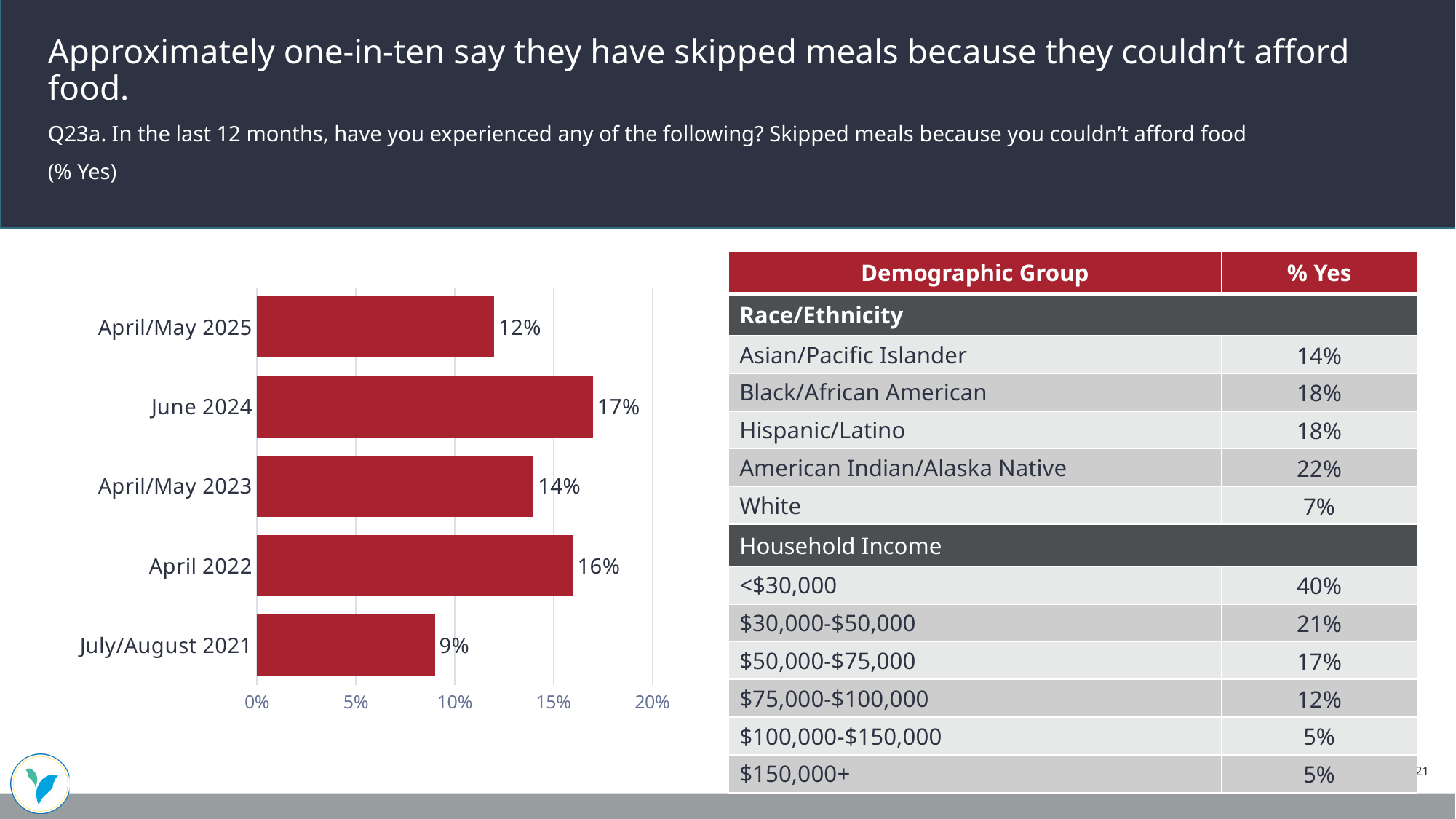
How many survey periods are shown in the bar chart? 5 Is the value for April 2022 greater or less than 15%? greater What is the value shown for June 2024? 17% What is the value shown for July/August 2021? 9% What type of chart is used to show the survey results by period? Bar chart What is the difference in percentage points between April/May 2023 and July/August 2021? 5 percentage points What percentage of respondents said they skipped meals in April/May 2025? 12% What is the difference in percentage points between June 2024 and April/May 2025? 5 percentage points Which survey period has the highest percentage of respondents who skipped meals? June 2024 Which survey period has the lowest percentage of respondents who skipped meals? July/August 2021 What is the highest value shown on the x axis of the bar chart? 20% Which is larger, the value for April 2022 or the value for April/May 2023? April 2022